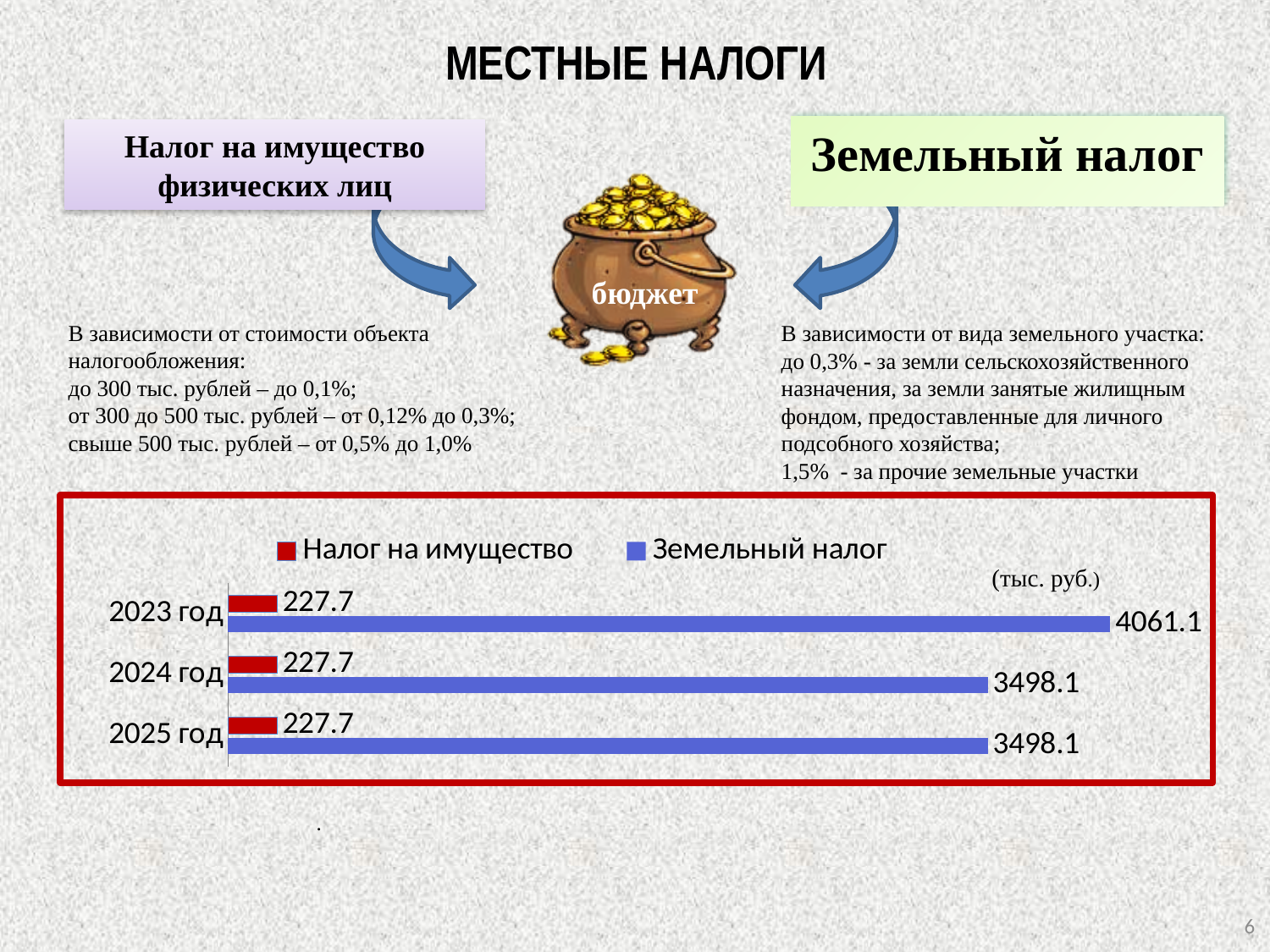
What is the value of Земельный налог for 2025 год? 3498.1 What is the difference between Земельный налог in 2023 год and 2024 год? 563 Which year has the highest value for Земельный налог? 2023 год What kind of chart is shown on the slide? bar chart What is the value of Налог на имущество for 2024 год? 227.7 What is the difference between Земельный налог and Налог на имущество in 2025 год? 3270.4 Which is larger in 2023 год: Налог на имущество or Земельный налог? Земельный налог What is the value of Земельный налог for 2023 год? 4061.1 How many years are shown on the chart? 3 How many series does the legend list? 2 What unit is indicated for the chart values? тыс. руб. Does the value of Налог на имущество change from 2023 год to 2025 год? No, it stays at 227.7